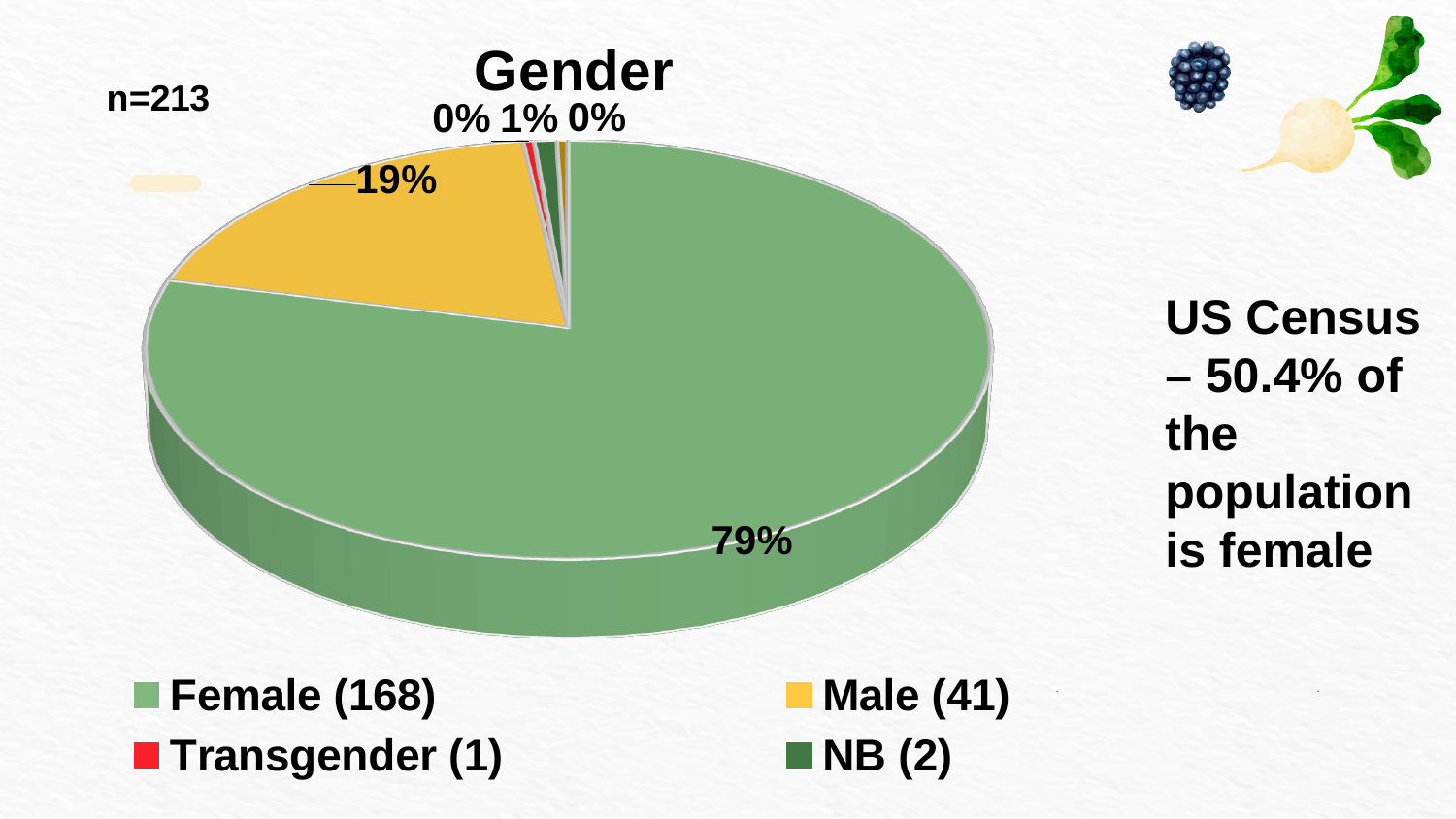
Which is larger, the Male slice or the NB slice? Male How many respondents are Male according to the legend? 41 How many respondents are NB according to the legend? 2 What is the title of the chart? Gender What is the difference in percentage points between the Female and Male slices? 60% How many respondents are Female according to the legend? 168 Which legend category has the smallest count? Transgender What percentage of the pie is the Female slice? 79% Which category has the largest slice of the pie? Female What type of chart is shown on the slide? pie chart What percentage of the pie is the Male slice? 19% How many entries does the legend list? 4